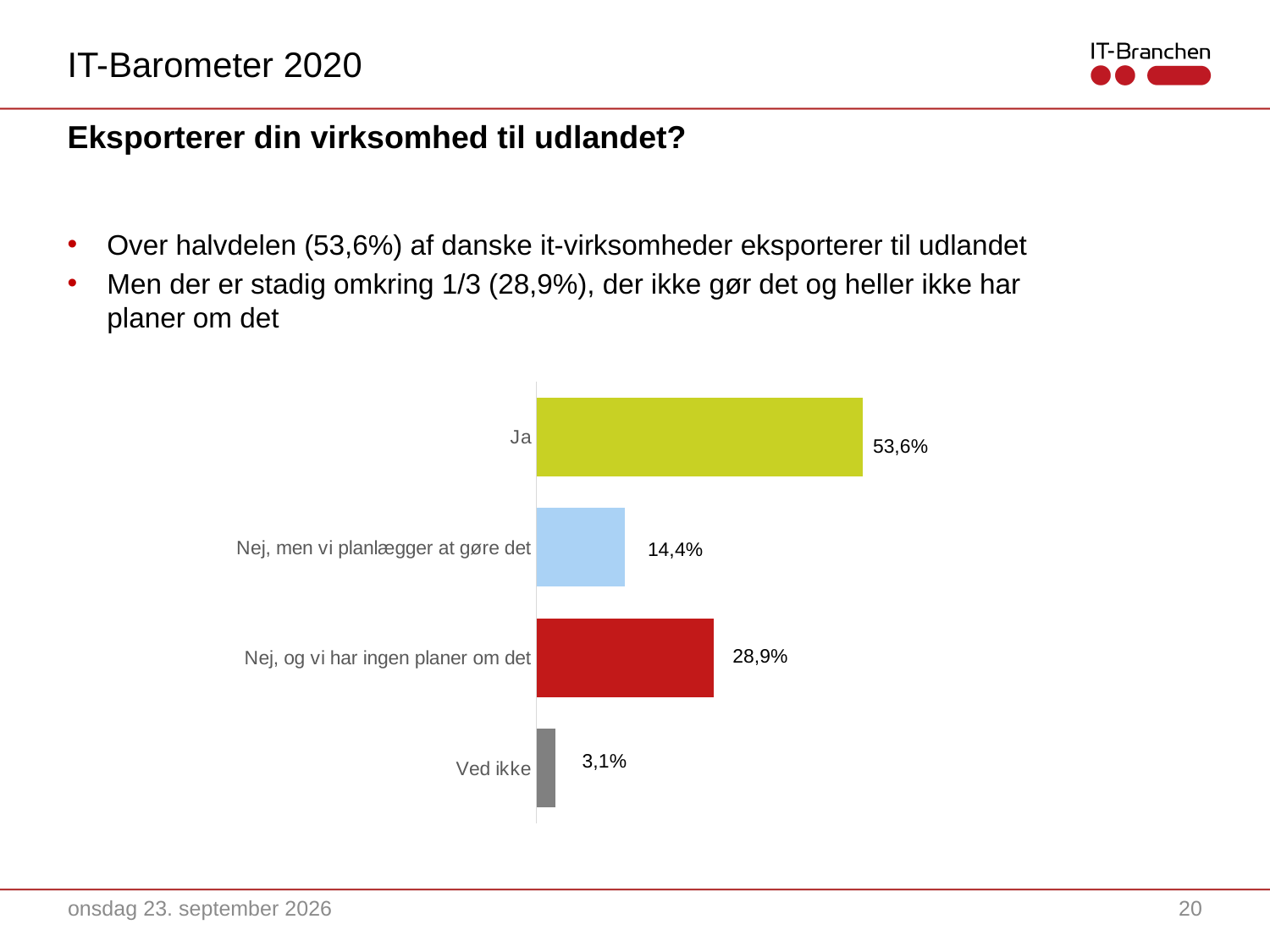
How many categories are shown in the chart? 4 What is the difference between the values for "Ja" and "Nej, og vi har ingen planer om det"? 24,7% What colour is the bar for "Nej, og vi har ingen planer om det"? Red What is the value for "Nej, men vi planlægger at gøre det"? 14,4% Which is larger: the value for "Nej, men vi planlægger at gøre det" or "Nej, og vi har ingen planer om det"? Nej, og vi har ingen planer om det What kind of chart is shown on the slide? Bar chart What is the difference between the values for "Nej, og vi har ingen planer om det" and "Nej, men vi planlægger at gøre det"? 14,5% What is the value for "Ved ikke"? 3,1% What is the value for "Nej, og vi har ingen planer om det"? 28,9% Which category has the highest value? Ja Which category has the lowest value? Ved ikke What is the value for "Ja"? 53,6%